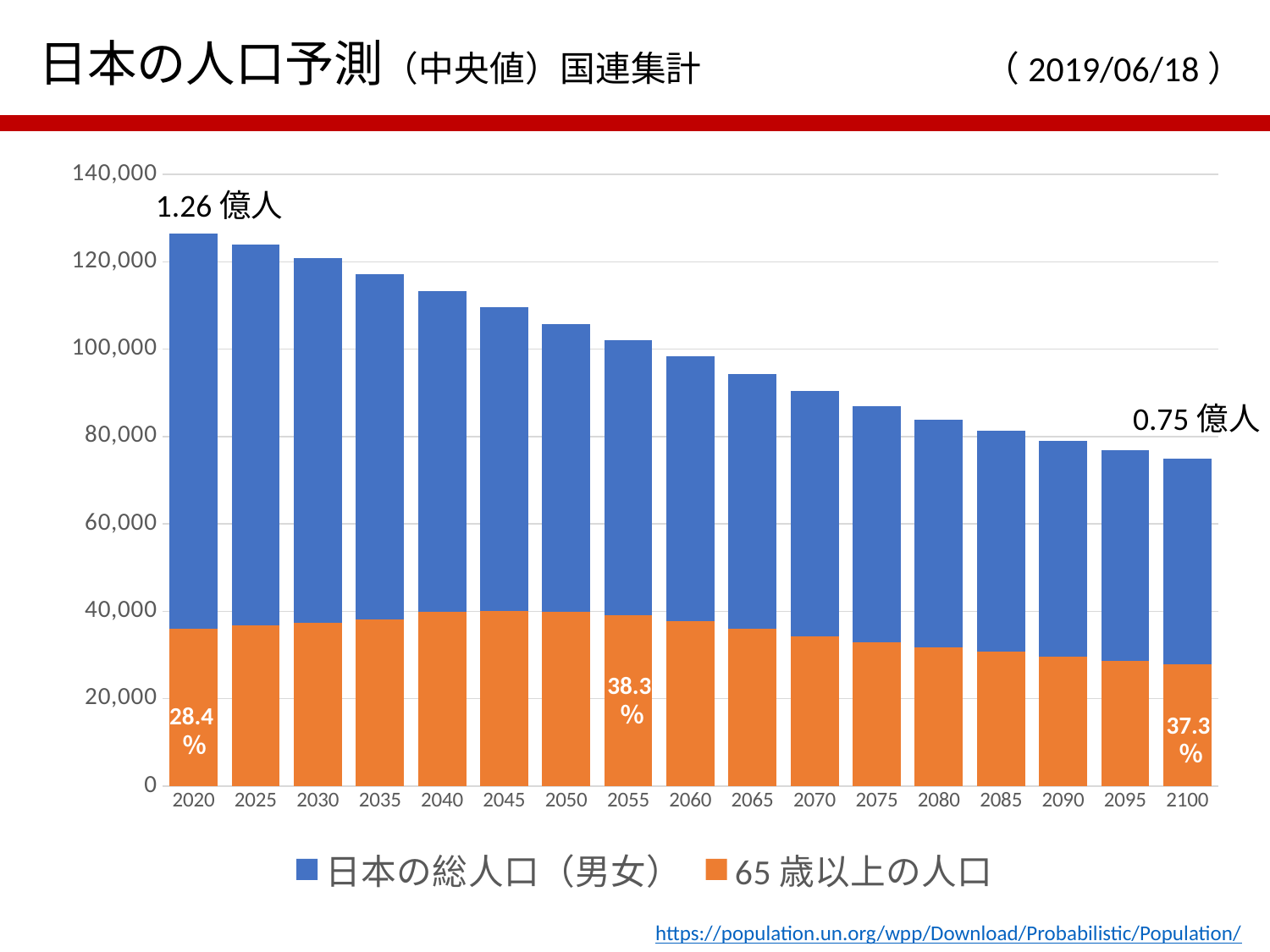
What kind of chart is shown on the slide? bar chart Is the value for 65 歳以上の人口 in 2020 greater or less than 40,000? less What percentage label is shown on the 2100 bar for 65 歳以上の人口? 37.3% What annotation is printed above the 2020 bar? 1.26 億人 How many years are shown along the x axis of the chart? 17 Which year has the highest value for 日本の総人口（男女）? 2020 Is the value for 日本の総人口（男女） in 2100 greater or less than 80,000? less What annotation is printed above the 2100 bar? 0.75 億人 What percentage label is shown on the 2020 bar for 65 歳以上の人口? 28.4% Does the value for 日本の総人口（男女） rise or fall from 2020 to 2100? fall What percentage label is shown on the 2055 bar for 65 歳以上の人口? 38.3% How many series does the chart legend list? 2